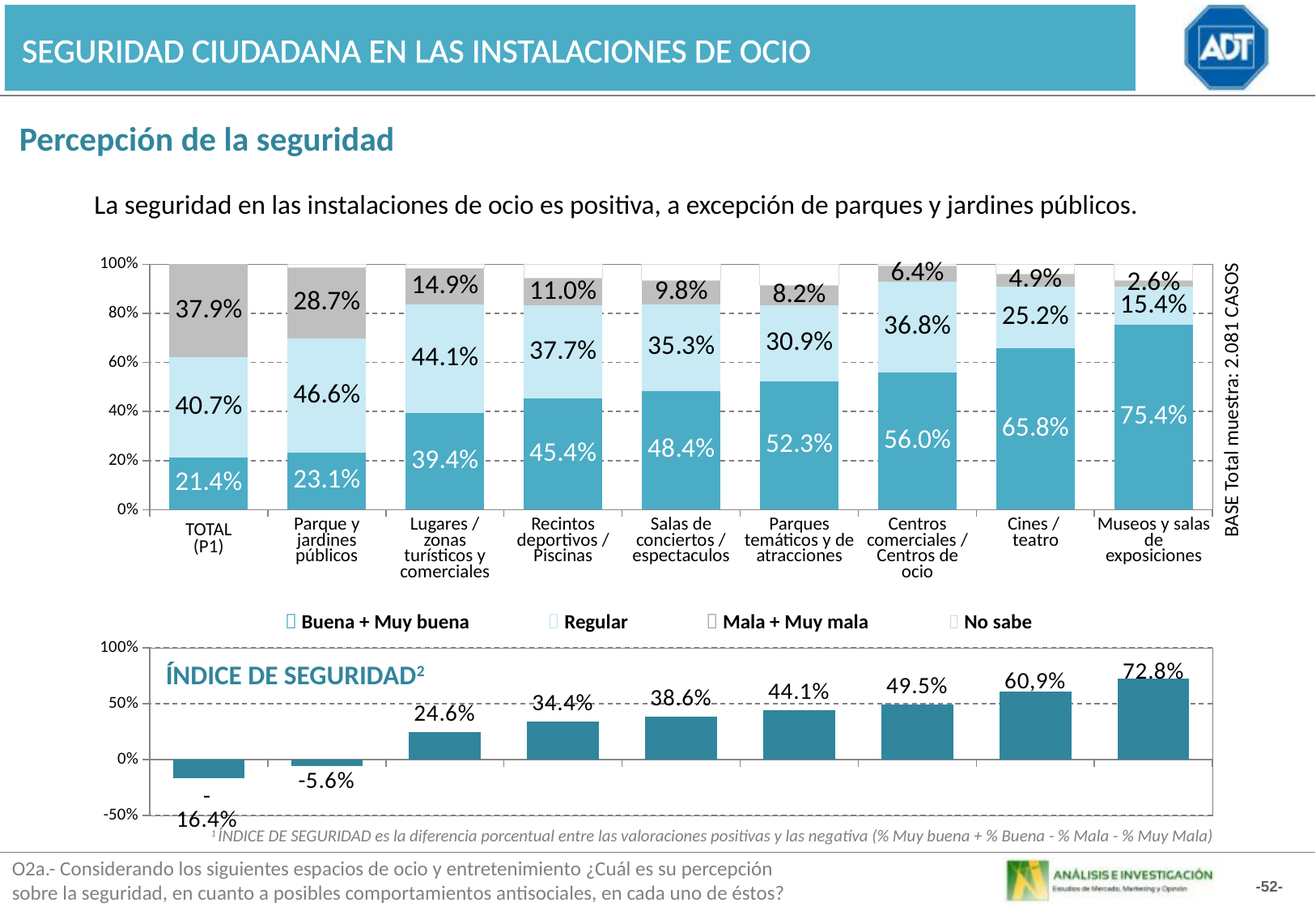
What kind of chart is the ÍNDICE DE SEGURIDAD chart at the bottom of the slide? bar chart In the top stacked bar chart, what is the 'Mala + Muy mala' value for TOTAL (P1)? 37.9% In the top stacked bar chart, which category has the highest 'Buena + Muy buena' value? Museos y salas de exposiciones How many series does the legend of the top stacked bar chart list? 4 In the top stacked bar chart, what is the 'Regular' value for Parque y jardines públicos? 46.6% In the ÍNDICE DE SEGURIDAD chart, what is the value for Parque y jardines públicos (second bar)? -5.6% In the top stacked bar chart, which category has the lowest 'Mala + Muy mala' value? Museos y salas de exposiciones How many categories are shown on the x axis of the top stacked bar chart? 9 In the top stacked bar chart, what is the 'Buena + Muy buena' value for Museos y salas de exposiciones? 75.4% In the ÍNDICE DE SEGURIDAD chart, is the value for Centros comerciales / Centros de ocio greater or less than 50%? less In the ÍNDICE DE SEGURIDAD chart, which bar has the lowest value? TOTAL (P1) In the top stacked bar chart, what is the difference between the 'Buena + Muy buena' values for Cines / teatro and Parques temáticos y de atracciones? 13.5%